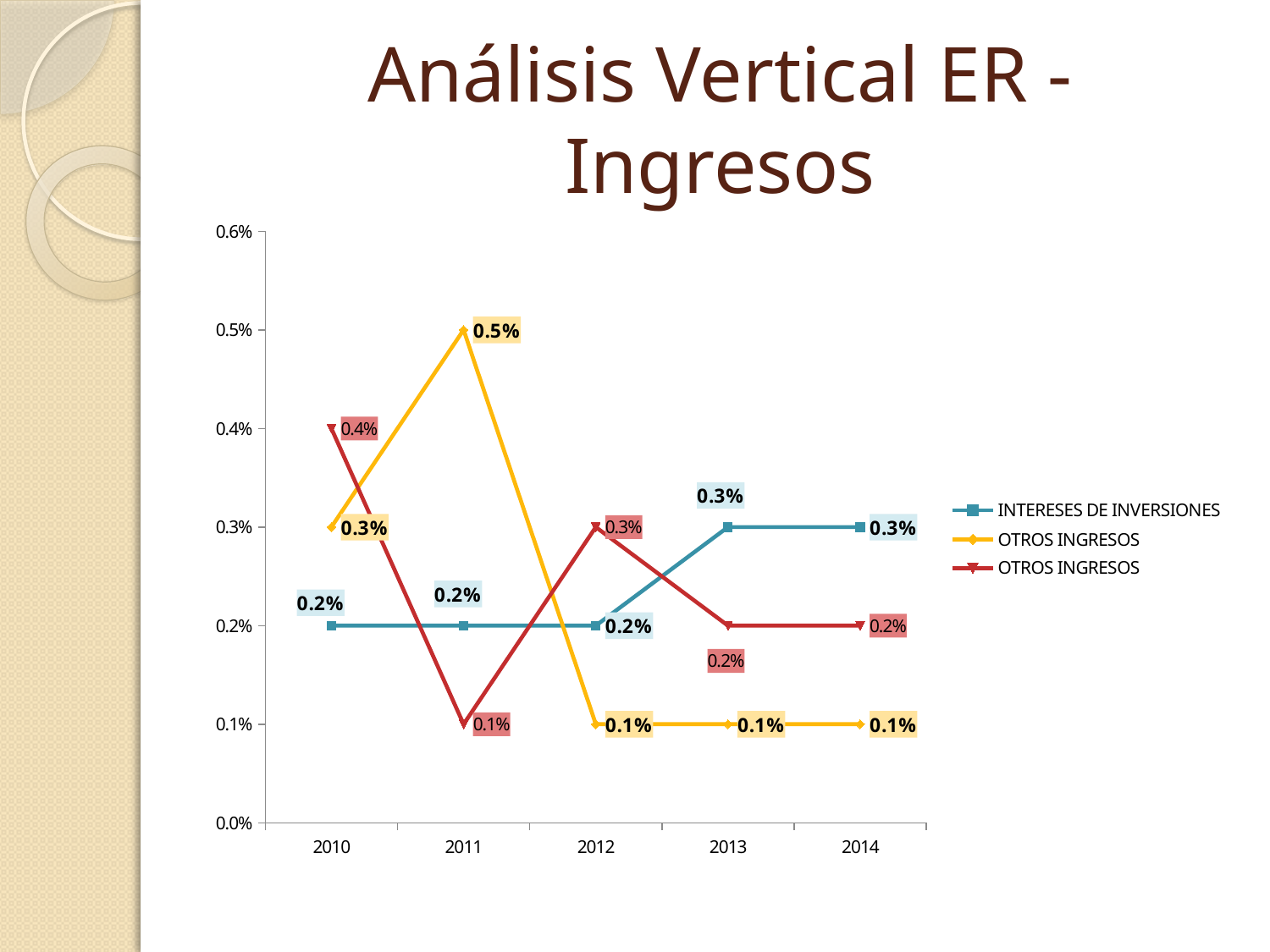
What is the value of the red OTROS INGRESOS series in 2010? 0.4% What is the value of the yellow OTROS INGRESOS series in 2011? 0.5% In which year does the yellow OTROS INGRESOS series reach its highest value? 2011 Does the yellow OTROS INGRESOS series rise or fall from 2011 to 2012? fall How many years are shown on the x axis? 5 How many series does the legend list? 3 What is the title of the slide containing the chart? Análisis Vertical ER - Ingresos What type of chart is shown on the slide? line chart In which year is the red OTROS INGRESOS series at its lowest value? 2011 What is the difference between the yellow OTROS INGRESOS value in 2011 and its value in 2012? 0.4% What is the value for INTERESES DE INVERSIONES in 2013? 0.3% In 2010, which is larger: the red OTROS INGRESOS series or INTERESES DE INVERSIONES? red OTROS INGRESOS